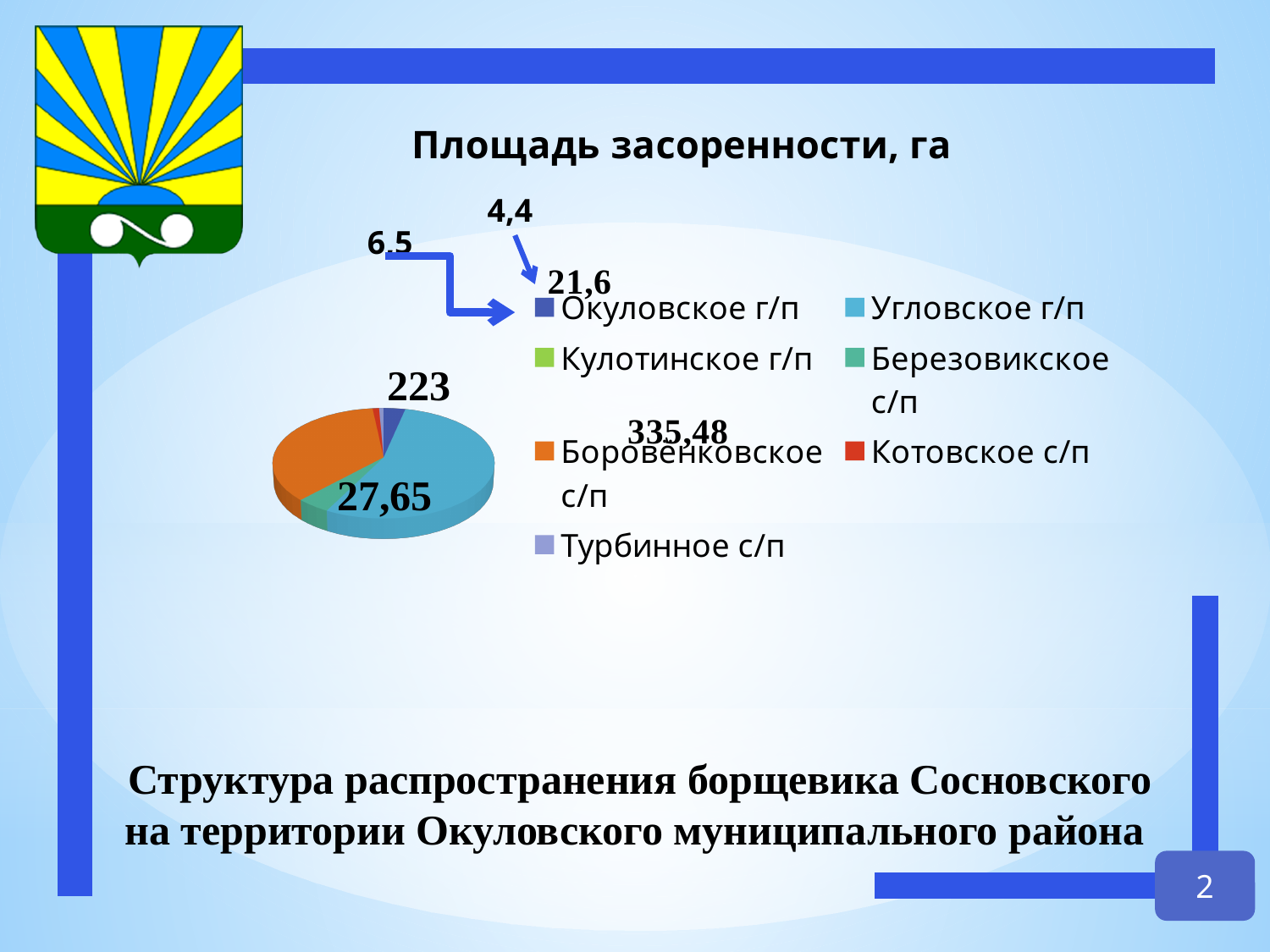
What is the largest data label value printed on the chart? 335,48 Which category has the largest slice of the pie? Угловское г/п Which slice is larger, Березовикское с/п or Котовское с/п? Березовикское с/п What is the title of the chart? Площадь засоренности, га What is the smallest data label value printed on the chart? 4,4 Which slice is larger, Боровенковское с/п or Березовикское с/п? Боровенковское с/п How many categories does the chart legend list? 7 What kind of chart is shown on the slide? pie chart Which slice is larger, Угловское г/п or Боровенковское с/п? Угловское г/п What colour is the slice for Боровенковское с/п in the legend? orange